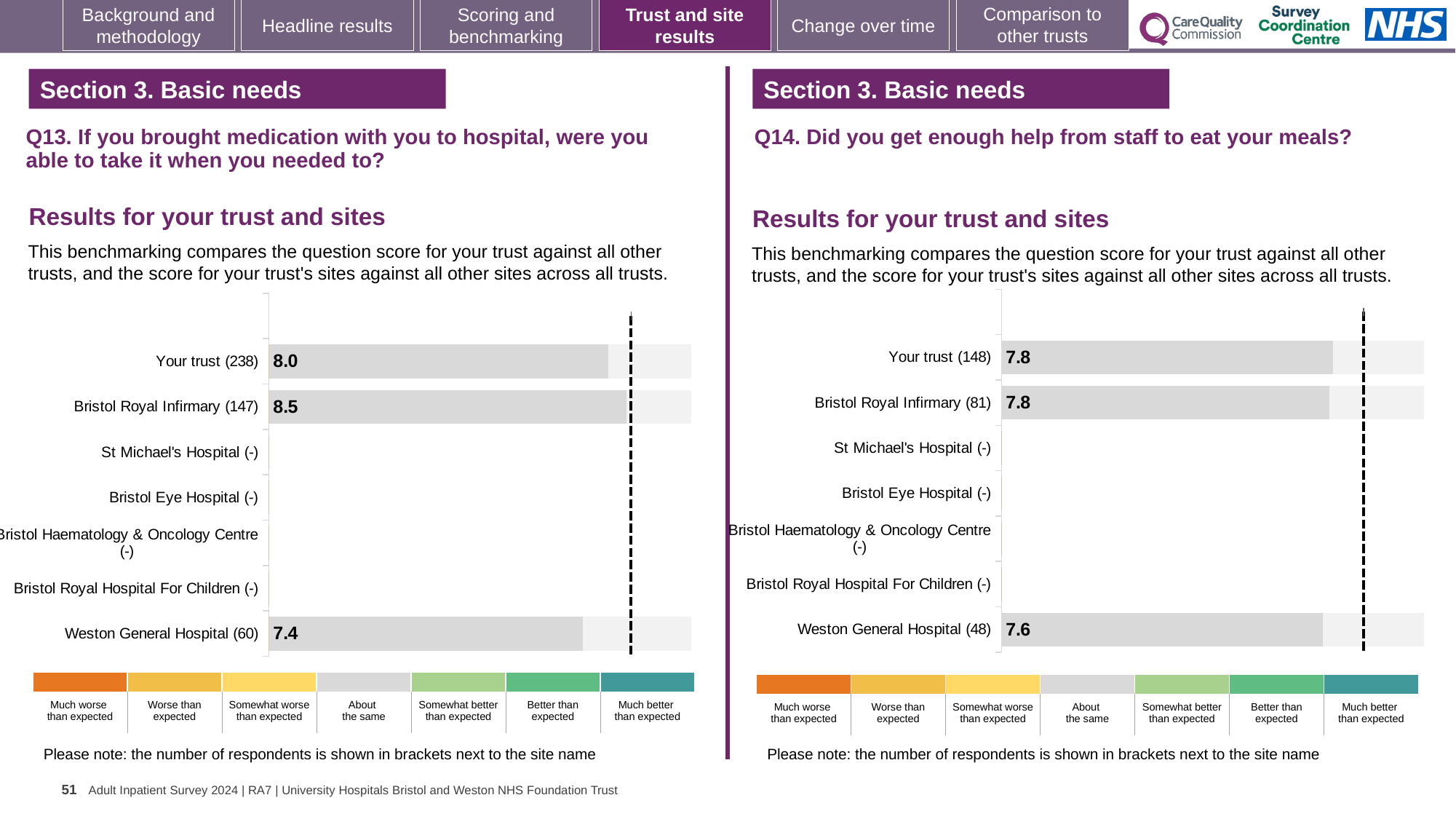
In the Q13 chart on the left, what is the difference between the scores for Bristol Royal Infirmary (147) and Weston General Hospital (60)? 1.1 In the Q13 chart on the left, which site with a plotted score has the lowest value? Weston General Hospital (60) In the Q14 chart on the right, what is the score for Weston General Hospital (48)? 7.6 In the Q13 chart on the left, which site with a plotted score has the highest value? Bristol Royal Infirmary (147) In the Q13 chart on the left, what is the score for Bristol Royal Infirmary (147)? 8.5 What kind of chart is used in the Q14 chart on the right? Bar chart In the Q14 chart on the right, what is the score for Your trust (148)? 7.8 In the Q14 chart on the right, what is the difference between the scores for Your trust (148) and Weston General Hospital (48)? 0.2 How many site rows (categories) are listed in the Q13 chart on the left? 7 In the Q13 chart on the left, what is the score for Your trust (238)? 8.0 In the Q13 chart on the left, what is the score for Weston General Hospital (60)? 7.4 In the Q14 chart on the right, which is larger, the score for Bristol Royal Infirmary (81) or Weston General Hospital (48)? Bristol Royal Infirmary (81)